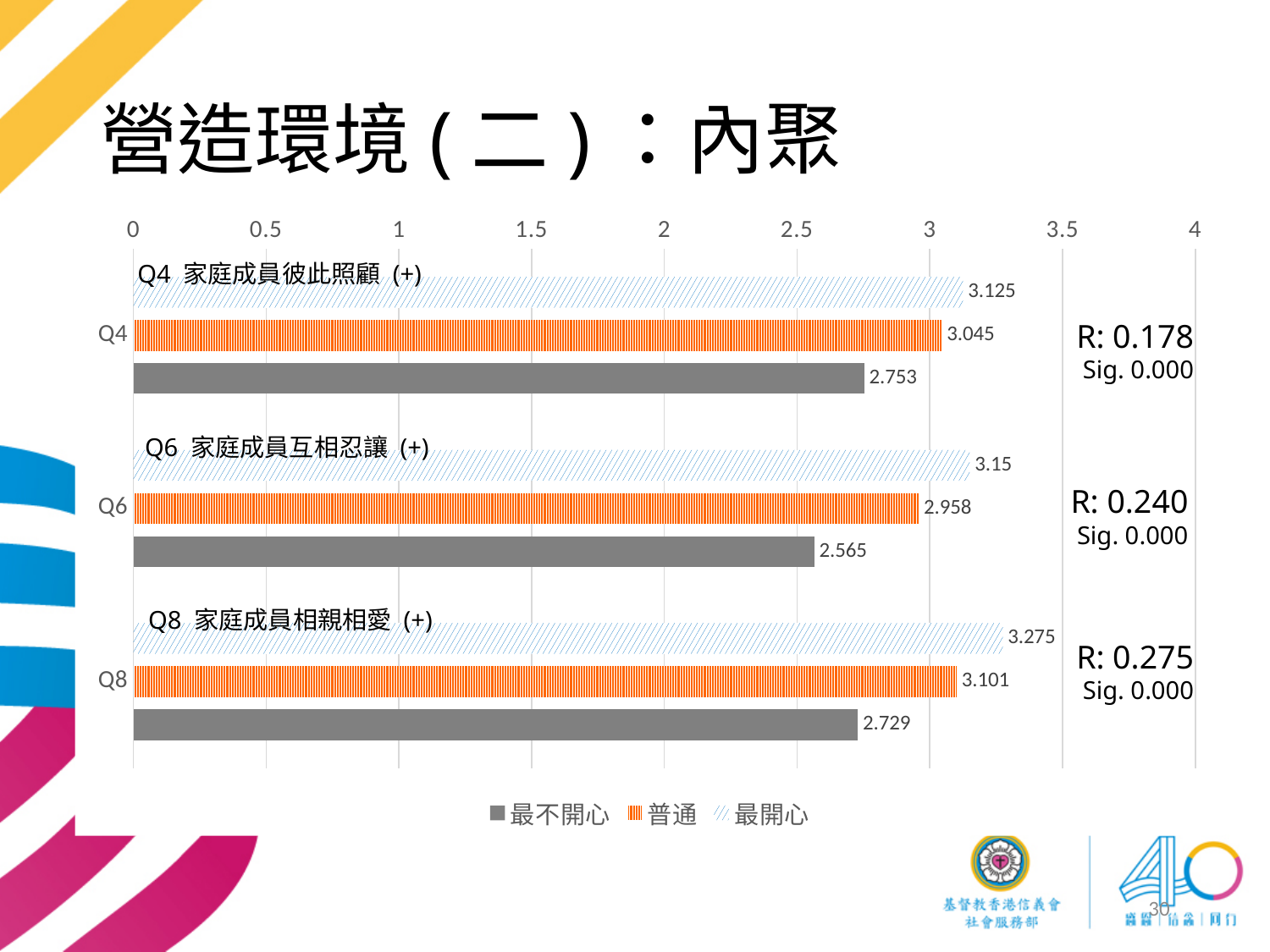
Which category has the highest 最開心 value? Q8 Is the 最不開心 value for Q4 greater or less than 3? less What is the value for 最開心 for Q4? 3.125 What is the R value shown next to Q8? R: 0.275 What is the value for 普通 for Q6? 2.958 How many categories (questions) are plotted on the chart? 3 What is the value for 最不開心 for Q8? 2.729 Which is larger for Q8: the 普通 value or the 最不開心 value? 普通 What kind of chart is shown on the slide? bar chart Which category has the lowest 最不開心 value? Q6 How many series does the legend list? 3 What is the difference between the 最開心 and 最不開心 values for Q6? 0.585